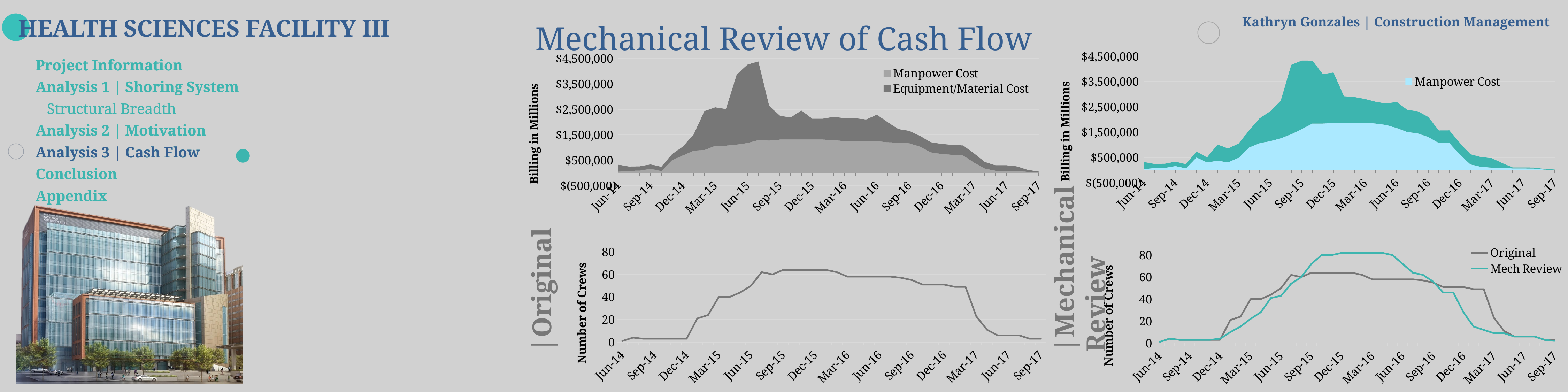
How many x-axis tick labels are shown on the bottom-left 'Original' Number of Crews chart? 14 In the bottom-left 'Original' Number of Crews chart, do the values rise or fall from Dec-16 to Jun-17? fall In the bottom-right 'Mechanical Review' Number of Crews chart, is the Mech Review value at Dec-15 greater or less than 60? greater What are the two legend entries on the top-left 'Original' cash flow chart? Manpower Cost, Equipment/Material Cost In the bottom-left 'Original' Number of Crews chart, is the value at Jun-17 greater or less than 20? less What kind of chart is the bottom-left 'Original' Number of Crews chart? line chart How many series does the legend of the top-left 'Original' cash flow chart list? 2 In the bottom-right 'Mechanical Review' Number of Crews chart, which series is higher at Dec-15, Original or Mech Review? Mech Review In the bottom-left 'Original' Number of Crews chart, is the value at Sep-15 greater or less than 40? greater What kind of chart is the top-left 'Original' cash flow chart? area chart How many series does the legend of the bottom-right 'Mechanical Review' Number of Crews chart list? 2